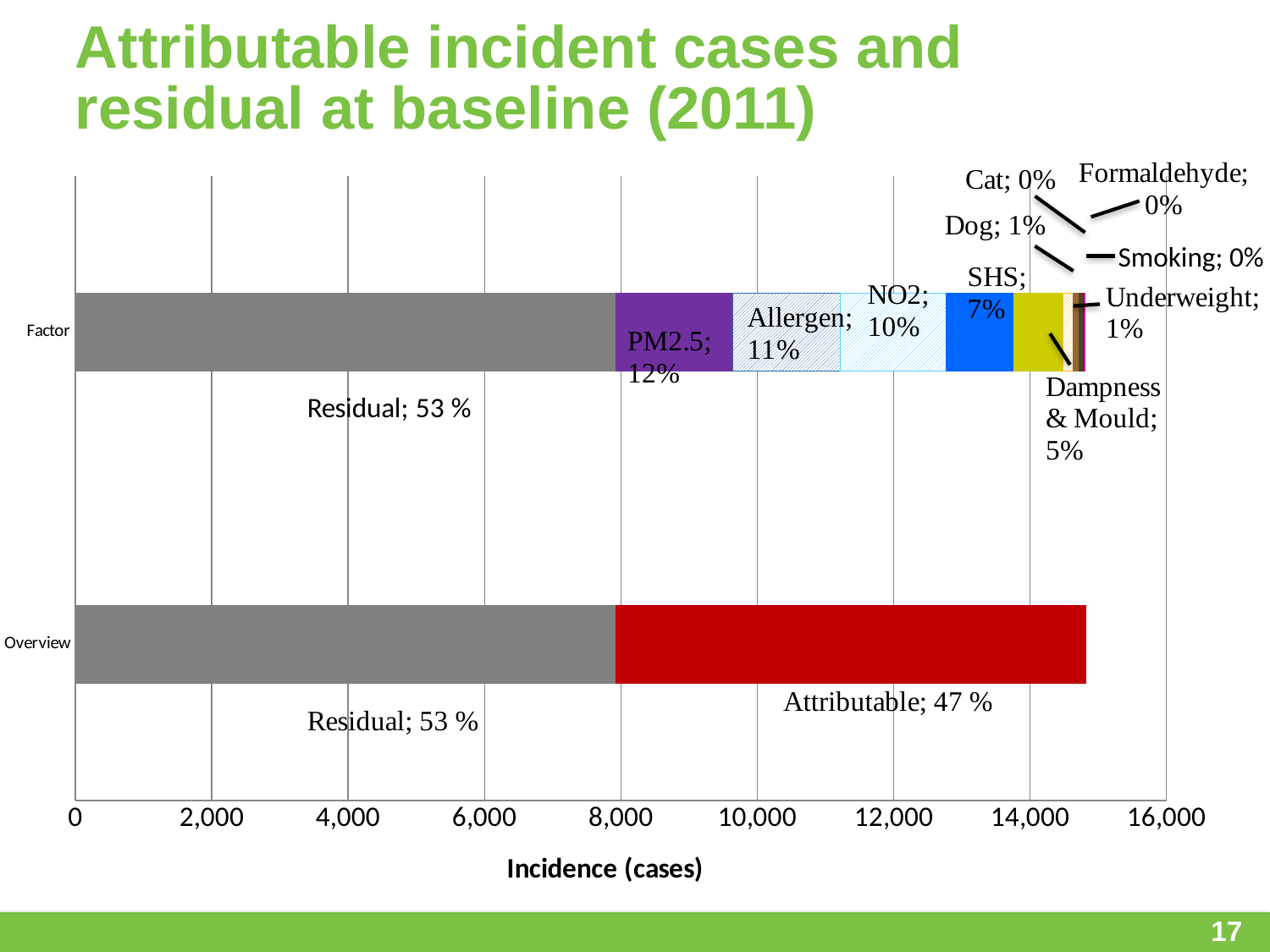
In the Overview bar, what share is labelled as Attributable? 47 % Which is larger in the Factor bar: the percentage for Allergen or the percentage for NO2? Allergen What is the title of the chart on the slide? Attributable incident cases and residual at baseline (2011) Is the total incidence shown by the Overview bar greater or less than 14,000 cases? greater What kind of chart is shown on the slide? bar chart In the Factor bar, what percentage is attributed to PM2.5? 12% How many bars (categories) are plotted on the vertical axis? 2 In the Factor bar, what percentage is attributed to SHS? 7% What is the label of the horizontal axis? Incidence (cases) In the Factor bar, what percentage is attributed to Dampness & Mould? 5% Among the attributable factors in the Factor bar, which has the largest percentage? PM2.5 In the Overview bar, what share is labelled as Residual? 53 %